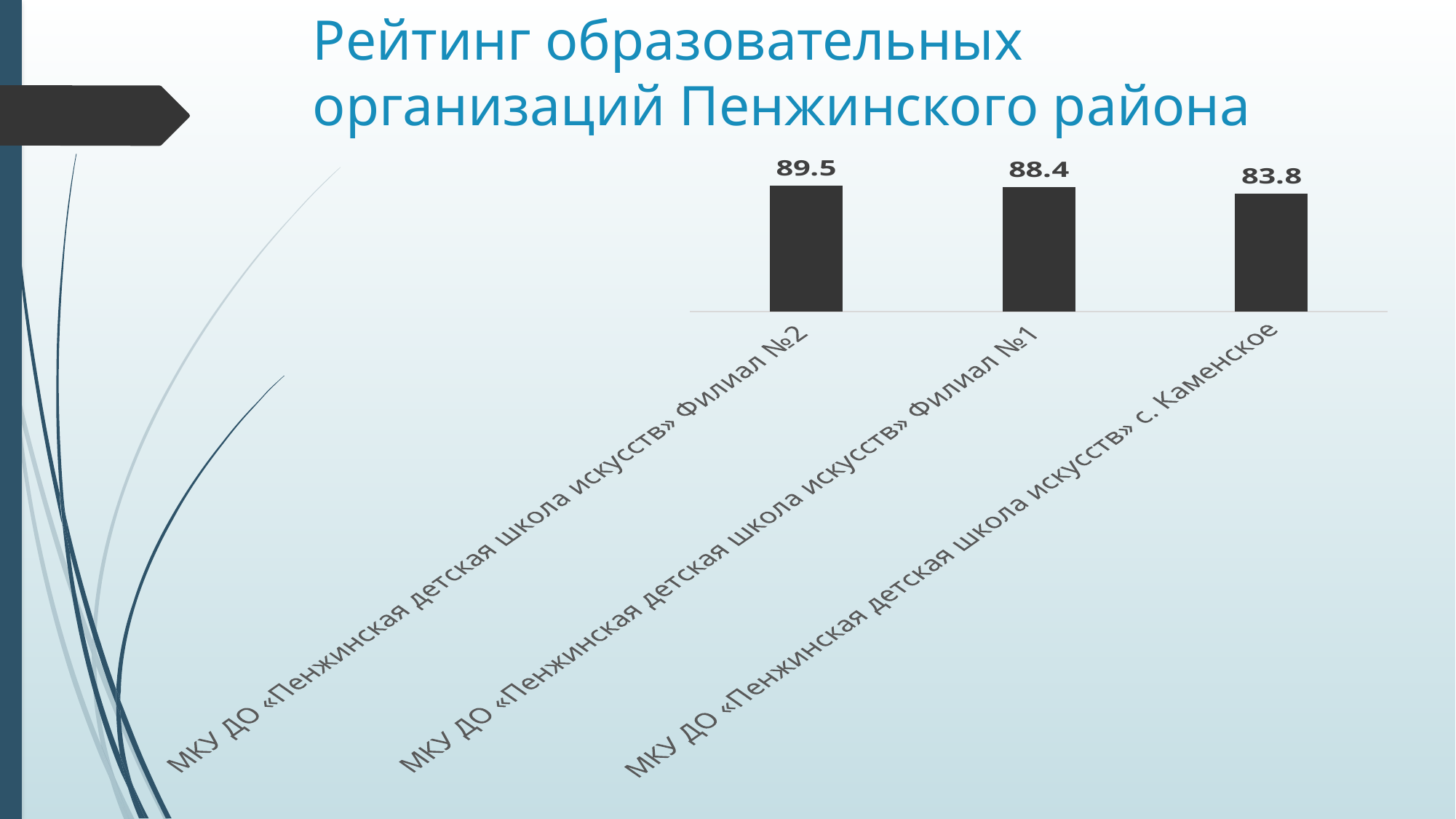
How many categories are shown on the chart? 3 What is the value for МКУ ДО «Пенжинская детская школа искусств» с. Каменское? 83.8 What is the difference between the values for Филиал №2 and Филиал №1? 1.1 Which is larger, the value for Филиал №1 or the value for с. Каменское? Филиал №1 Which category has the lowest value? МКУ ДО «Пенжинская детская школа искусств» с. Каменское Do the values rise or fall from left to right across the chart? Fall What kind of chart is shown on the slide? Bar chart What is the difference between the values for Филиал №1 and с. Каменское? 4.6 What is the difference between the highest and lowest values on the chart? 5.7 What is the value for МКУ ДО «Пенжинская детская школа искусств» Филиал №2? 89.5 Which category has the highest value? МКУ ДО «Пенжинская детская школа искусств» Филиал №2 What is the value for МКУ ДО «Пенжинская детская школа искусств» Филиал №1? 88.4